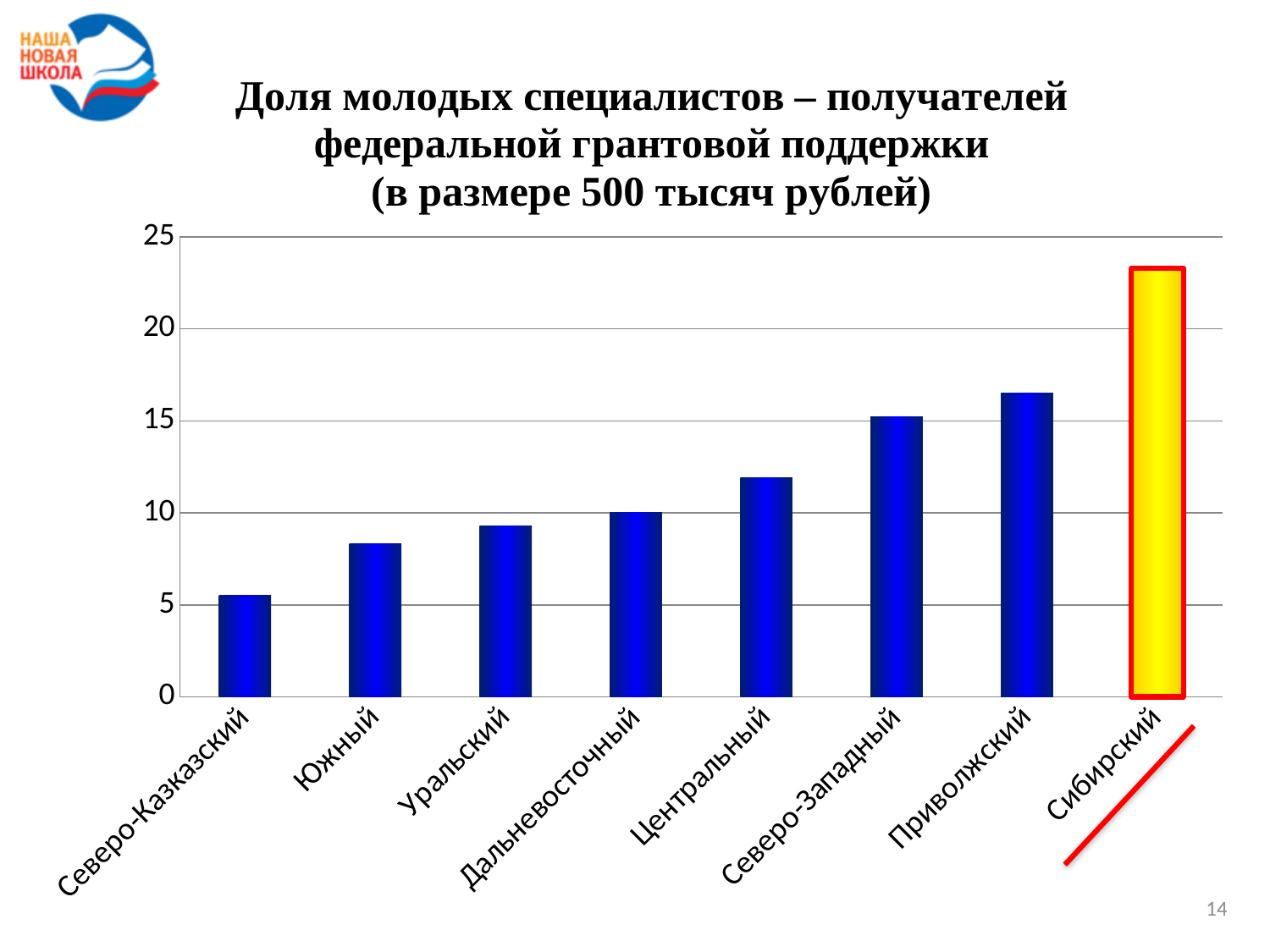
How many federal districts (categories) are shown on the x axis? 8 Is the value for Южный greater or less than 10? less Is the value for Приволжский greater or less than 15? greater Is the value for Северо-Кавказский greater or less than 10? less What kind of chart is shown on the slide? bar chart Which bar is highlighted in yellow with a red outline? Сибирский Which is larger, the value for Северо-Западный or the value for Уральский? Северо-Западный Which district has the highest value? Сибирский Do the values rise or fall from left to right along the x axis? rise Which district has the lowest value? Северо-Казказский